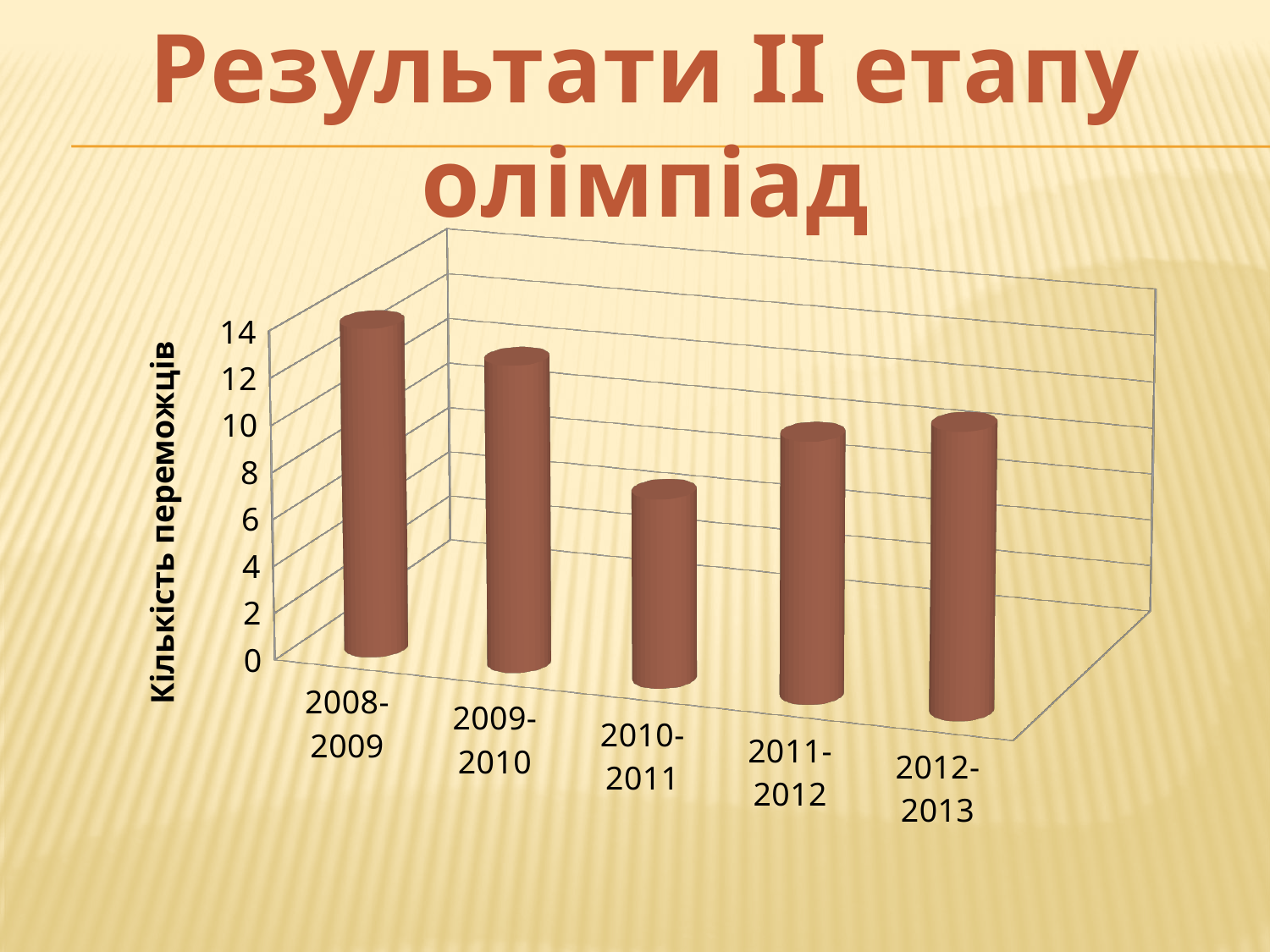
Which is larger, the value for 2008-2009 or the value for 2010-2011? 2008-2009 Is the value for 2010-2011 greater or less than 10? less Is the value for 2009-2010 greater or less than 8? greater Is the value for 2008-2009 greater or less than 10? greater What kind of chart is shown on the slide? bar chart How many categories (school years) are shown on the x axis of the chart? 5 Which is larger, the value for 2009-2010 or the value for 2011-2012? 2009-2010 What is the label of the vertical axis of the chart? Кількість переможців Which school year has the highest number of winners in the chart? 2008-2009 Which school year has the lowest number of winners in the chart? 2010-2011 What is the title of the slide containing the chart? Результати ІІ етапу олімпіад